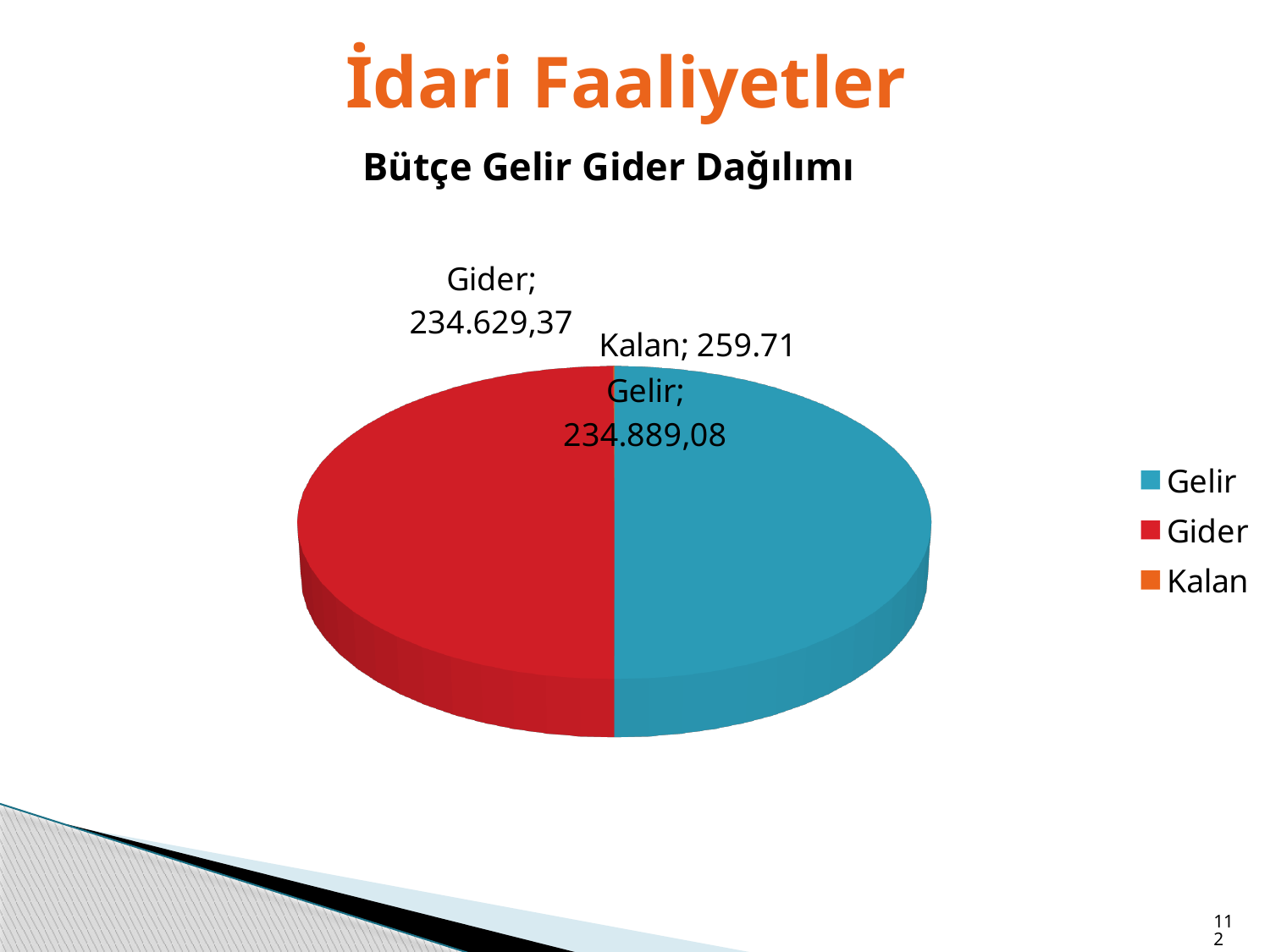
What is the value shown for Gider in the pie chart? 234.629,37 What is the value shown for Kalan in the pie chart? 259.71 What is the value shown for Gelir in the pie chart? 234.889,08 What colour represents Gider in the pie chart? Red What is the difference between the values for Gelir and Gider? 259,71 How many entries does the legend list? 3 Which category has the smallest value in the pie chart? Kalan What is the title of the chart? Bütçe Gelir Gider Dağılımı How many categories are shown in the pie chart? 3 What kind of chart is shown on the slide? Pie chart Which is larger, the value for Gelir or the value for Kalan? Gelir